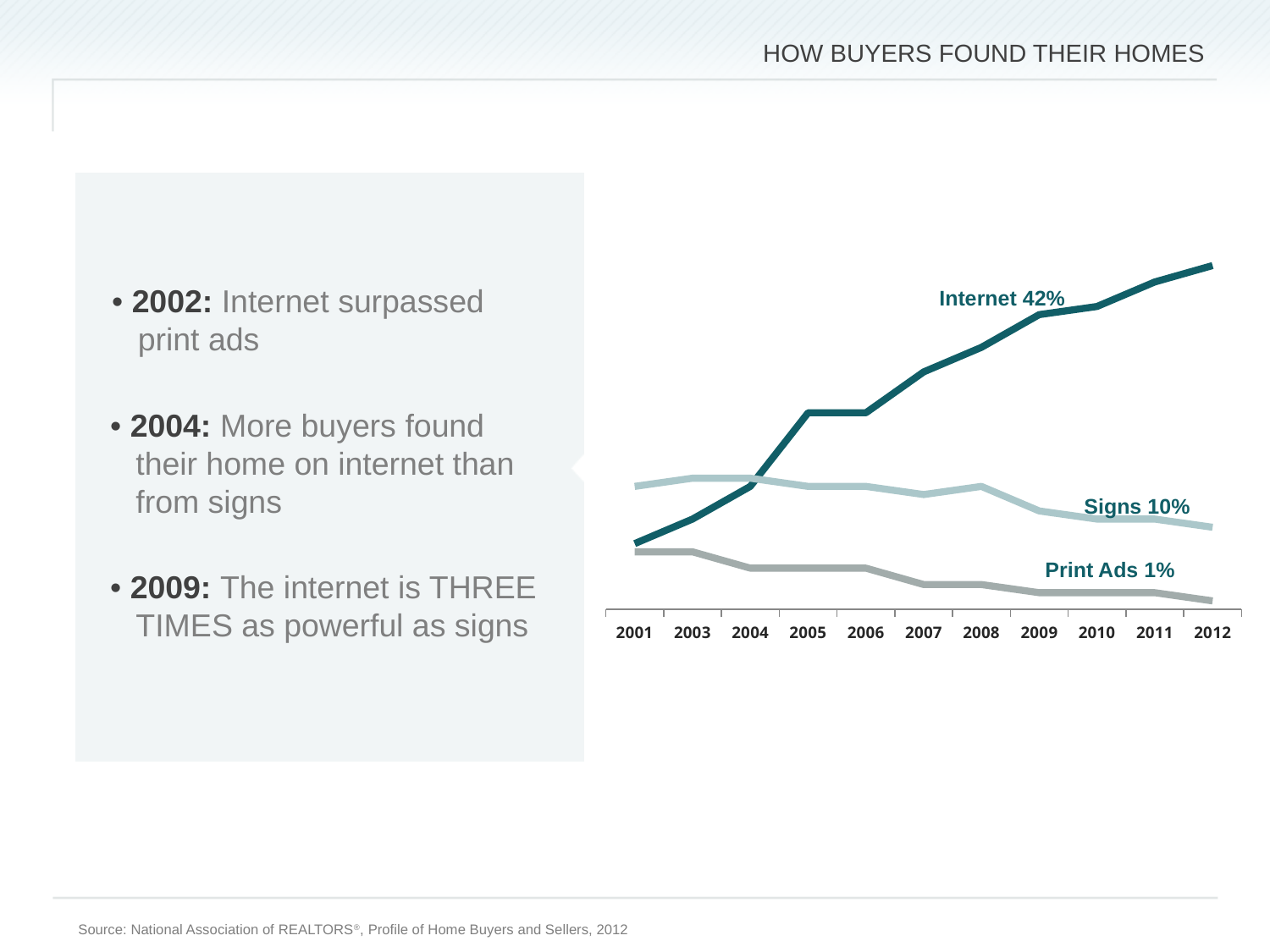
What percentage is labelled for Signs at the end of the line? 10% Which series has the highest value in 2012? Internet What is the title of the chart on the slide? HOW BUYERS FOUND THEIR HOMES What percentage is labelled for Internet at the end of the line? 42% How many years are labelled on the x axis of the chart? 11 What kind of chart is shown on the slide? line chart Does the Internet line rise or fall from 2001 to 2012? rise Does the Print Ads line rise or fall from 2001 to 2012? fall How many series are plotted in the chart? 3 Which series has the lowest value in 2012? Print Ads What percentage is labelled for Print Ads at the end of the line? 1% What is the difference between the labelled Internet value (42%) and the labelled Signs value (10%)? 32 percentage points